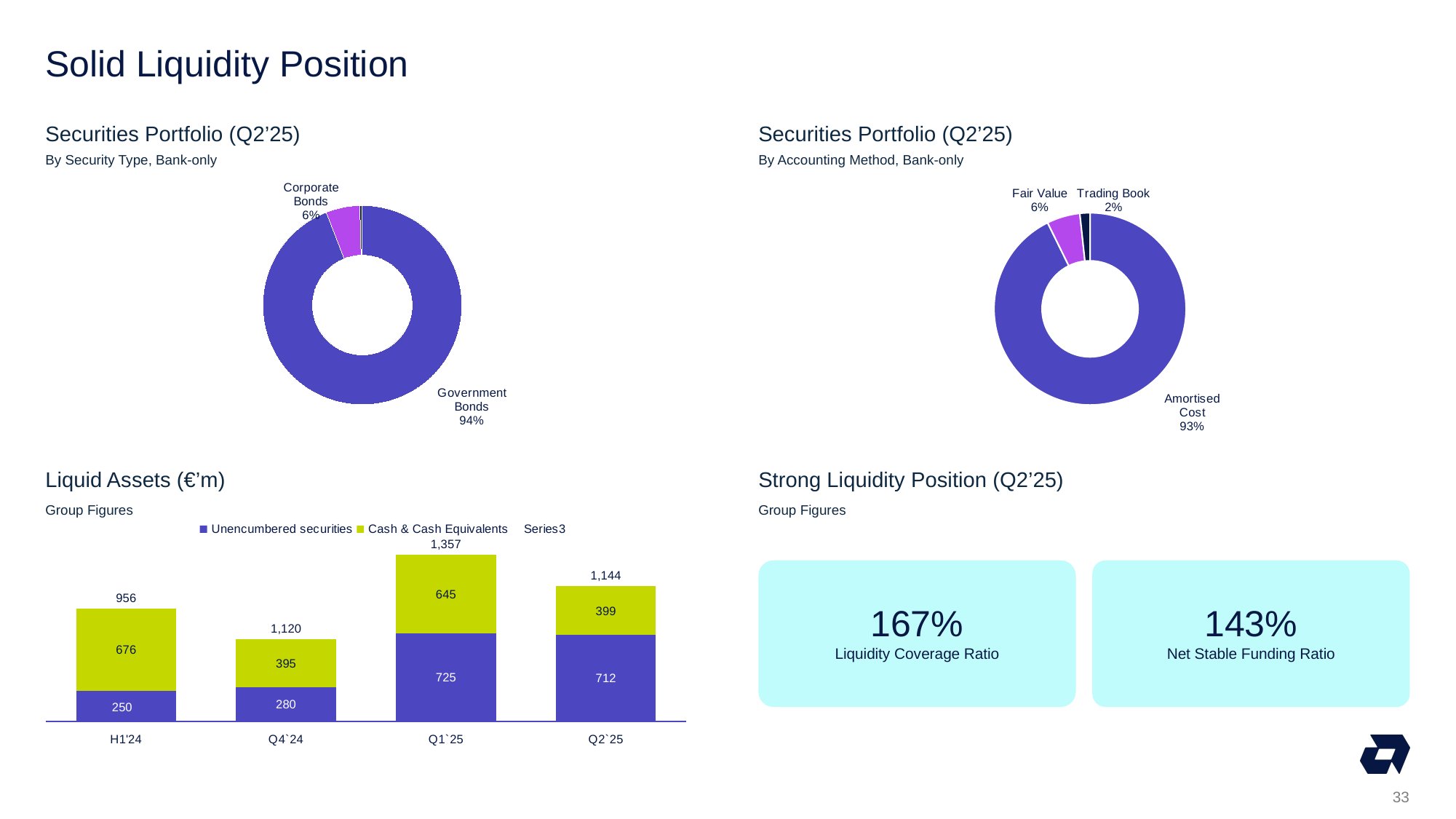
In the Liquid Assets (€'m) chart, which period has the highest Unencumbered securities value? Q1'25 In the Securities Portfolio by Accounting Method donut chart, what share is Fair Value? 6% In the Securities Portfolio by Security Type donut chart, what share is Corporate Bonds? 6% What kind of chart is the Liquid Assets (€'m) chart? Stacked bar chart How many periods are shown on the x axis of the Liquid Assets (€'m) chart? 4 In the Securities Portfolio by Security Type donut chart, what share is Government Bonds? 94% How many series does the legend of the Liquid Assets (€'m) chart list? 3 In the Liquid Assets (€'m) chart, what is the value of Cash & Cash Equivalents for H1'24? 676 In the Securities Portfolio by Accounting Method donut chart, which category has the smallest share? Trading Book In the Liquid Assets (€'m) chart, what is the value of Unencumbered securities for Q1'25? 725 In the Liquid Assets (€'m) chart, what is the difference between Unencumbered securities in Q1'25 and Q2'25? 13